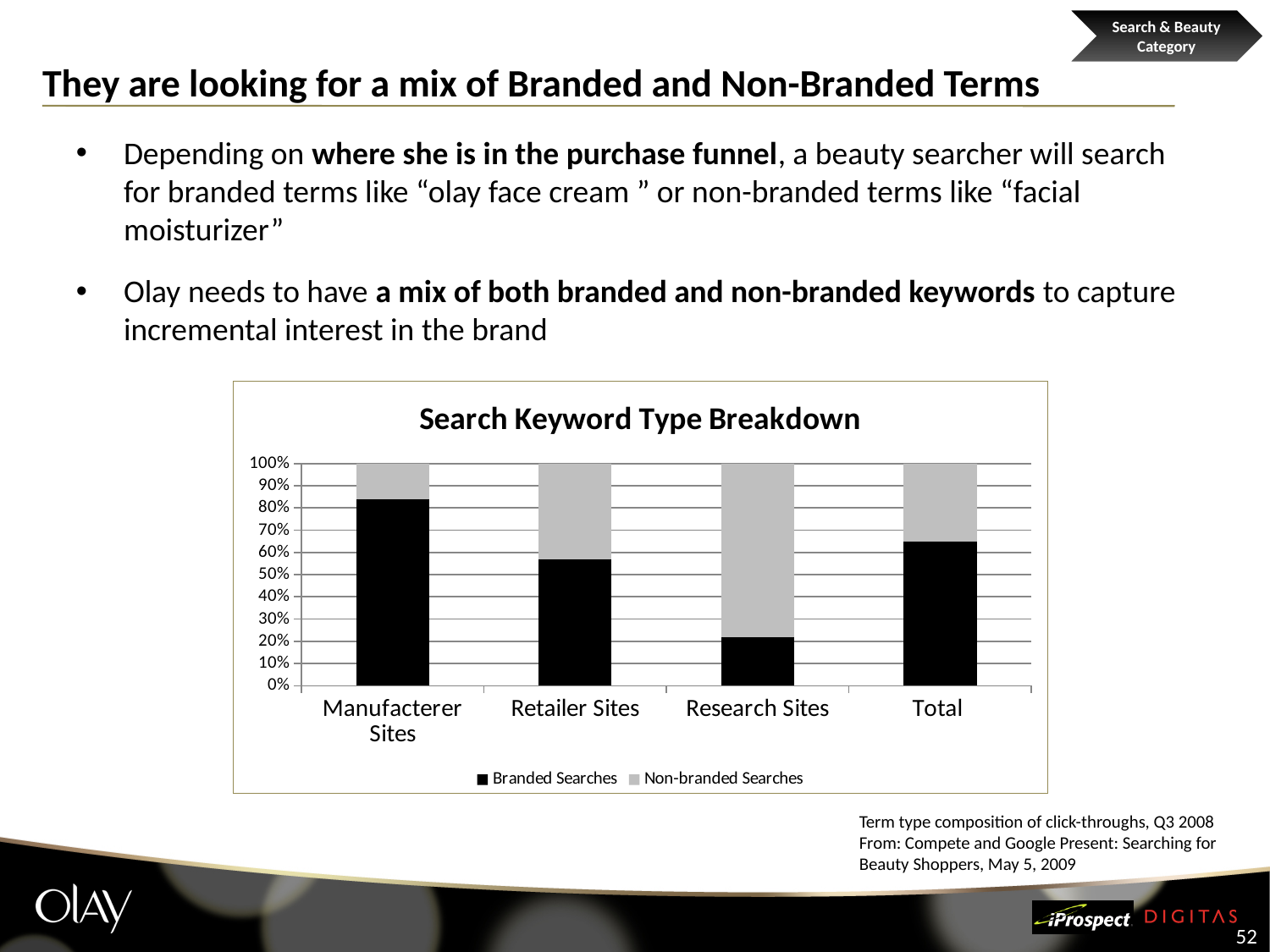
Which has a larger share of Branded Searches, Retailer Sites or Total? Total What is the title of the chart? Search Keyword Type Breakdown Which category has the highest share of Branded Searches? Manufacterer Sites How many series does the chart's legend list? 2 Which category has the largest share of Non-branded Searches? Research Sites Is the Branded Searches share for Research Sites greater or less than 30%? less Is the Branded Searches share for Manufacterer Sites greater or less than 80%? greater Which category has the lowest share of Branded Searches? Research Sites How many categories are shown on the x axis of the chart? 4 Which colour represents Non-branded Searches in the chart? Gray What kind of chart is shown on the slide? Stacked bar chart Does the Branded Searches share rise or fall from Manufacterer Sites to Research Sites? fall